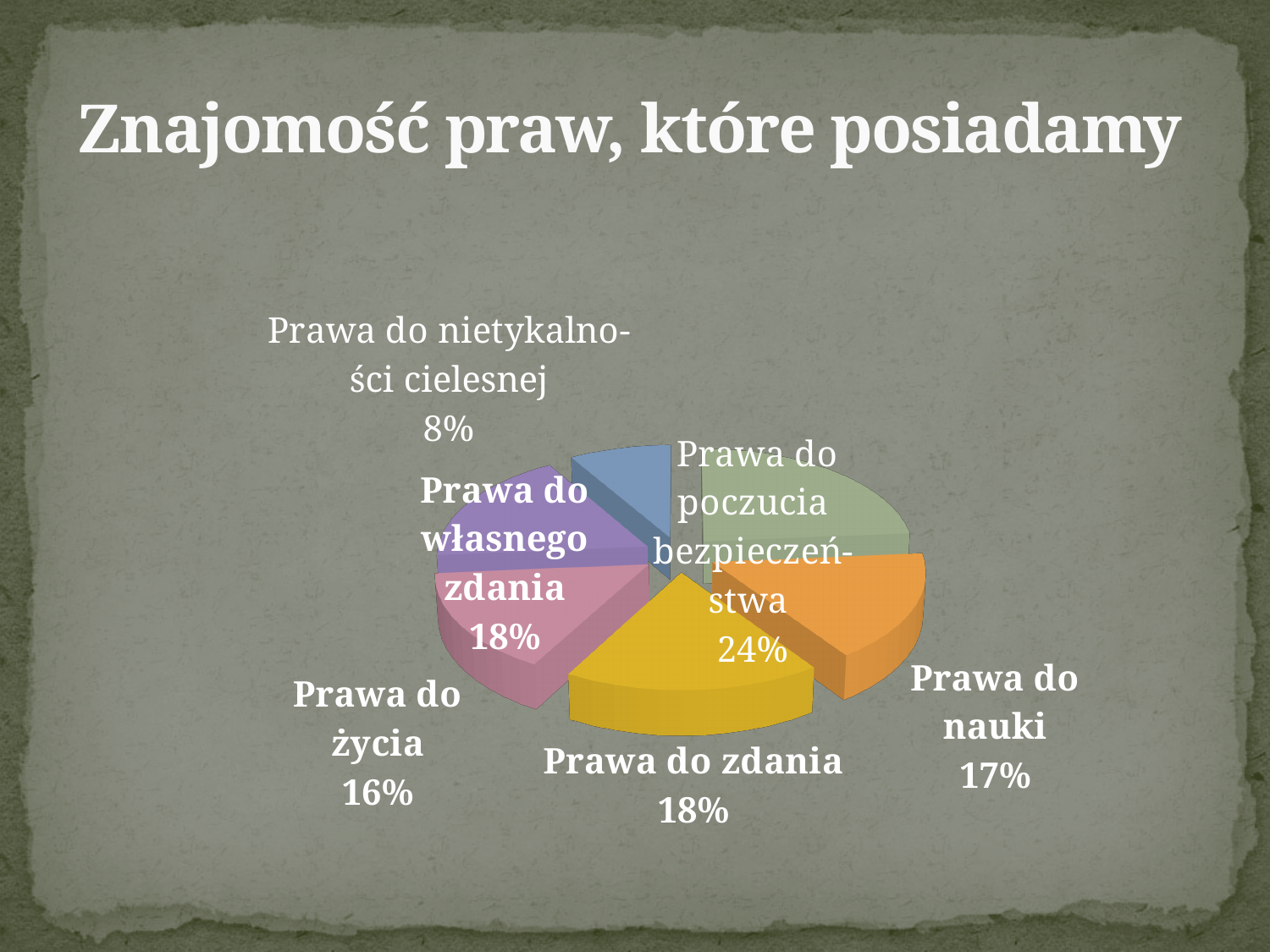
What percentage is shown for "Prawa do życia"? 16% What is the difference in percentage points between "Prawa do poczucia bezpieczeństwa" and "Prawa do nauki"? 7 What percentage is shown for "Prawa do poczucia bezpieczeństwa"? 24% Which category has the smallest share of the pie? Prawa do nietykalności cielesnej Which is larger, the share for "Prawa do nauki" or the share for "Prawa do życia"? Prawa do nauki What percentage is shown for "Prawa do nauki"? 17% What percentage is shown for "Prawa do nietykalności cielesnej"? 8% Which category has the largest share of the pie? Prawa do poczucia bezpieczeństwa What percentage is shown for "Prawa do własnego zdania"? 18% What is the title of the chart on the slide? Znajomość praw, które posiadamy How many slices does the pie chart have? 6 What kind of chart is shown on the slide? pie chart